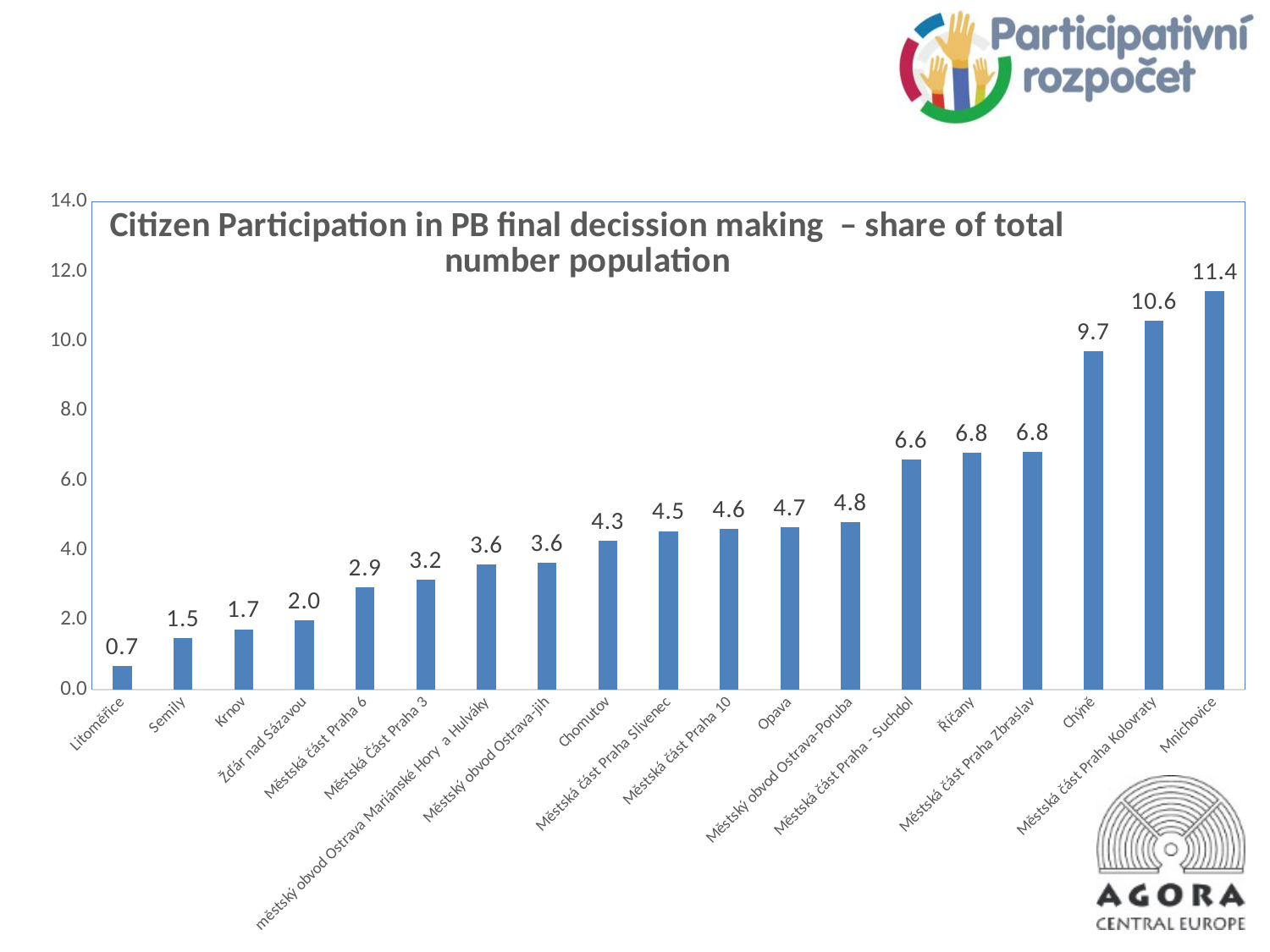
What is the value for Chýně? 9.7 How many categories are shown on the x axis? 19 Which category has the lowest value? Litoměřice What is the value for Mnichovice? 11.4 Do the values generally rise or fall from left to right along the x axis? Rise What is the value for Chomutov? 4.3 Which category has the highest value? Mnichovice What is the value for Semily? 1.5 Which is larger, the value for Opava or the value for Krnov? Opava What is the difference between the values for Mnichovice and Městská část Praha Kolovraty? 0.8 What kind of chart is shown on the slide? Bar chart Is the value for Chýně greater or less than 8.0? greater